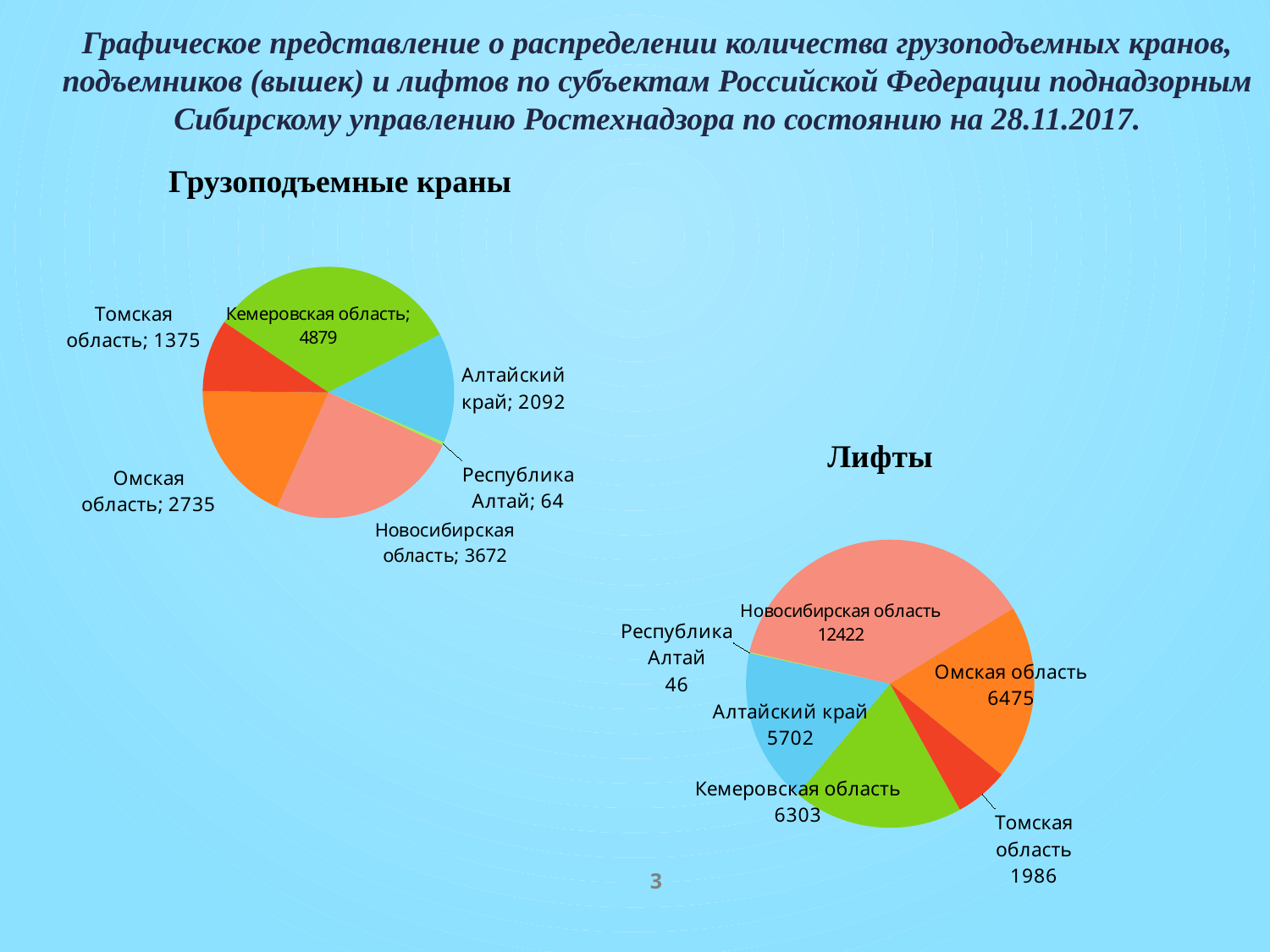
In the 'Грузоподъемные краны' chart, which region has the largest slice? Кемеровская область In the 'Грузоподъемные краны' chart, which is larger: Омская область or Алтайский край? Омская область In the 'Лифты' chart, what is the value for Алтайский край? 5702 In the 'Лифты' chart, what is the difference between Омская область and Кемеровская область? 172 In the 'Лифты' chart, which region has the largest value? Новосибирская область How many regions are shown in the 'Лифты' chart? 6 In the 'Лифты' chart, which region has the smallest slice? Республика Алтай What type of chart is the 'Грузоподъемные краны' chart? Pie chart In the 'Грузоподъемные краны' chart, what is the difference between Кемеровская область and Новосибирская область? 1207 In the 'Лифты' chart, what is the value for Республика Алтай? 46 In the 'Грузоподъемные краны' chart, how many cranes are shown for Новосибирская область? 3672